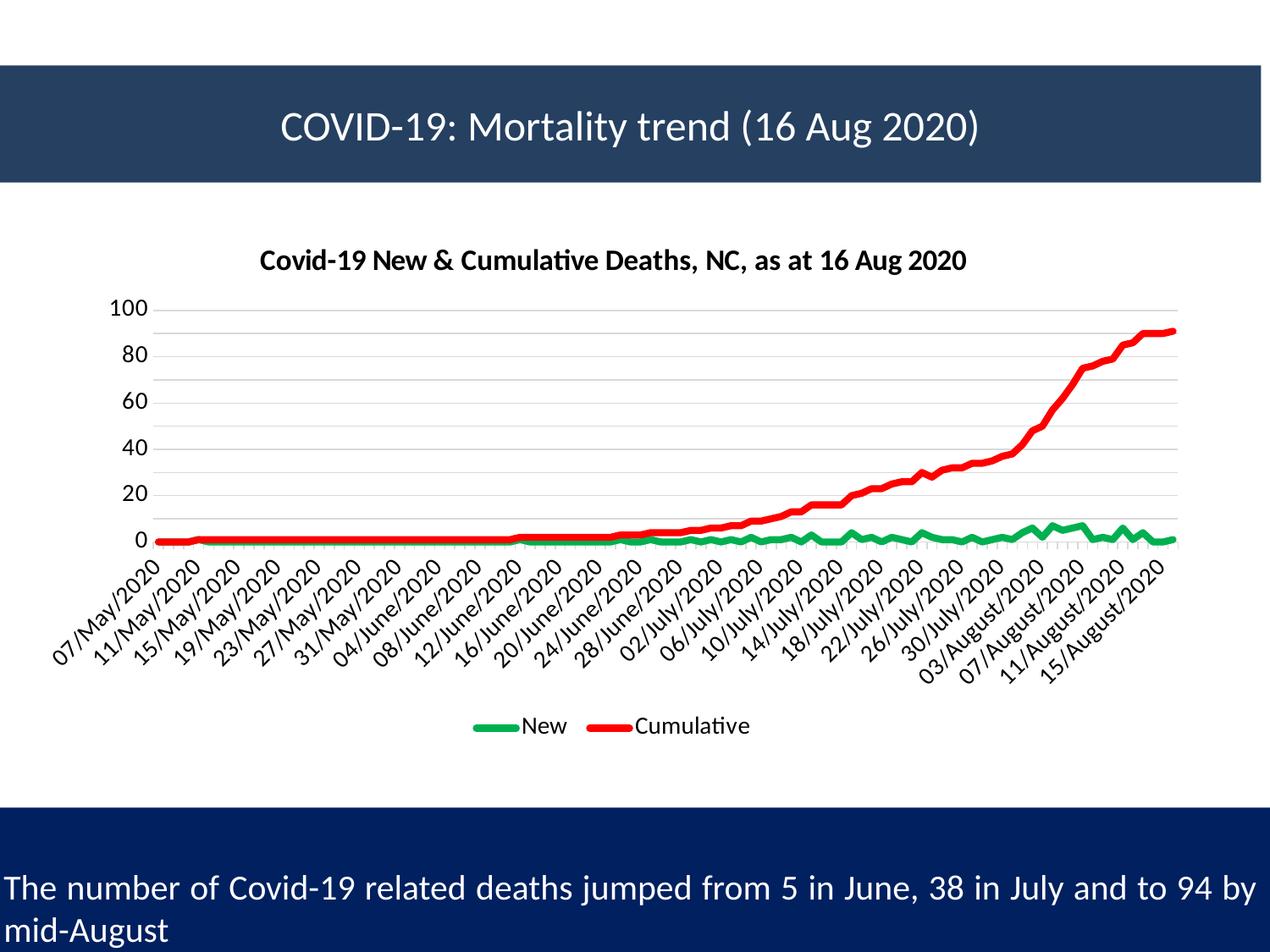
On 15/August/2020, which series has the larger value, New or Cumulative? Cumulative Is the Cumulative value on 07/May/2020 greater or less than 20? less Is the Cumulative value on 30/July/2020 greater or less than 20? greater How many series does the legend list? 2 What are the two series named in the legend? New and Cumulative Does the Cumulative line rise or fall from 07/May/2020 to 15/August/2020? Rise Is the Cumulative value on 14/July/2020 greater or less than 20? less Which series reaches the highest value on the chart? Cumulative What kind of chart is shown on the slide? Line chart What colour is the Cumulative line? Red